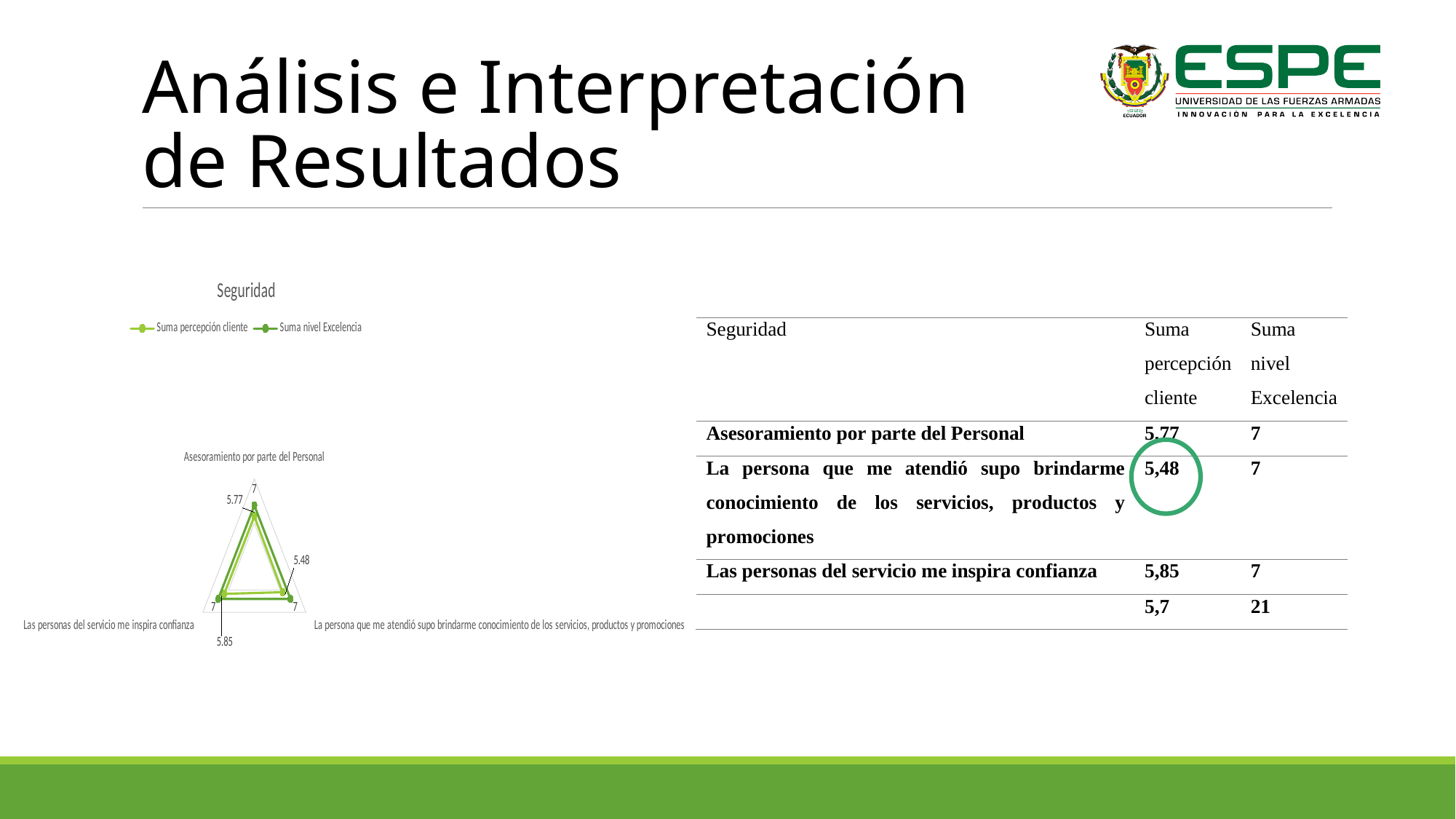
What is the difference between the Suma nivel Excelencia and Suma percepción cliente values for Asesoramiento por parte del Personal? 1.23 What is the title of the chart? Seguridad What is the value of Suma nivel Excelencia for Asesoramiento por parte del Personal? 7 Which category has the lowest Suma percepción cliente value? La persona que me atendió supo brindarme conocimiento de los servicios, productos y promociones Which series has the larger value for Las personas del servicio me inspira confianza, Suma percepción cliente or Suma nivel Excelencia? Suma nivel Excelencia Which category has the highest Suma percepción cliente value? Las personas del servicio me inspira confianza How many categories (axes) does the radar chart have? 3 What is the value of Suma percepción cliente for La persona que me atendió supo brindarme conocimiento de los servicios, productos y promociones? 5.48 How many series does the chart legend list? 2 What is the value of Suma percepción cliente for Asesoramiento por parte del Personal? 5.77 What is the value of Suma percepción cliente for Las personas del servicio me inspira confianza? 5.85 What kind of chart is shown on the slide? Radar chart